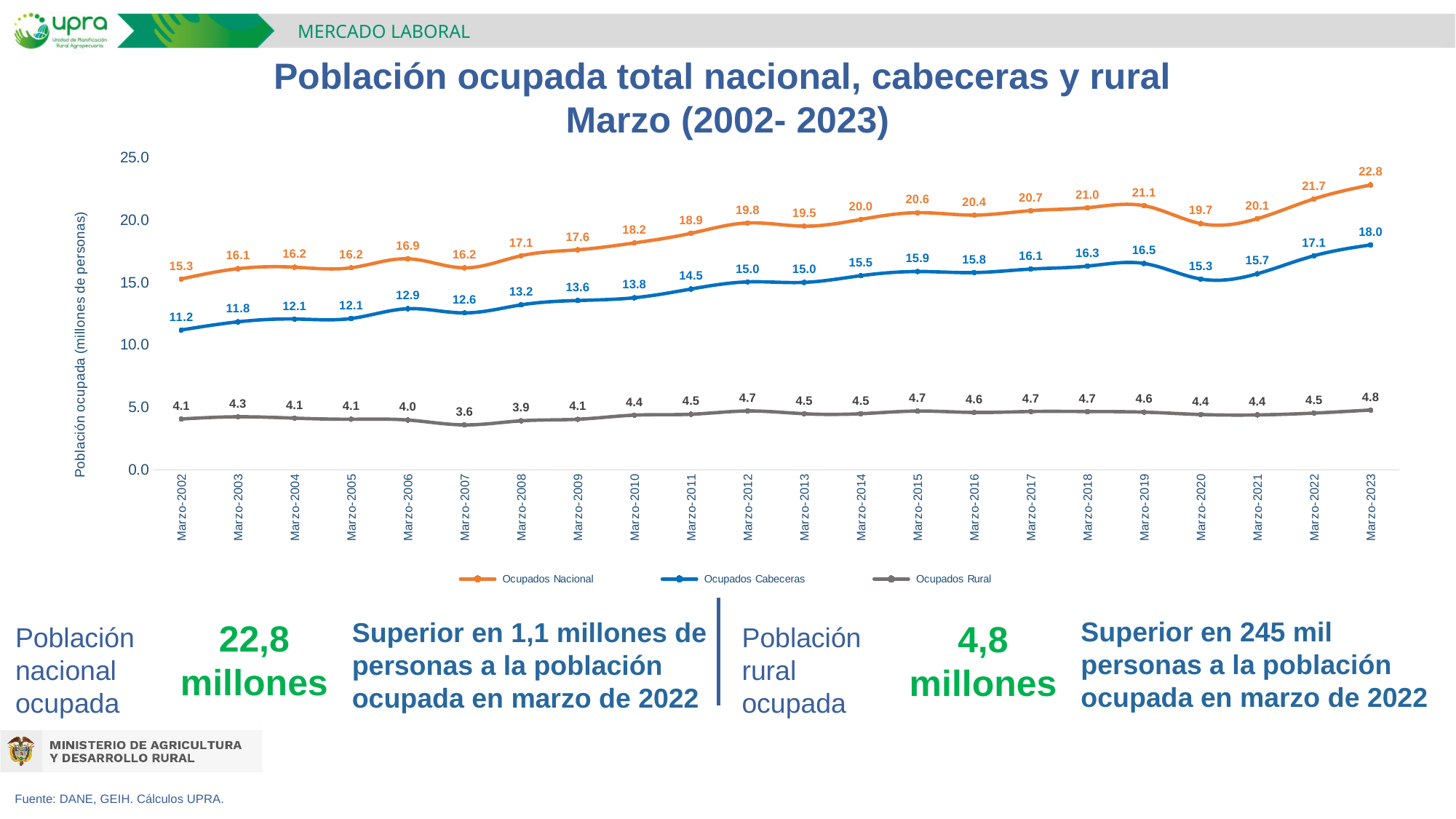
In which year does Ocupados Nacional reach its highest value? Marzo-2023 What kind of chart is shown on the slide? Line chart Which is larger: Ocupados Cabeceras in Marzo-2019 or in Marzo-2020? Marzo-2019 How many time points (years) are shown on the x axis? 22 What is the label of the y axis? Población ocupada (millones de personas) How many series does the legend list? 3 What is the value of Ocupados Nacional for Marzo-2023? 22.8 What is the value of Ocupados Cabeceras for Marzo-2002? 11.2 What is the difference between Ocupados Nacional in Marzo-2023 and Marzo-2022? 1.1 What is the value of Ocupados Rural for Marzo-2007? 3.6 In which year is Ocupados Rural at its lowest value? Marzo-2007 Does Ocupados Cabeceras generally rise or fall from Marzo-2002 to Marzo-2023? Rise